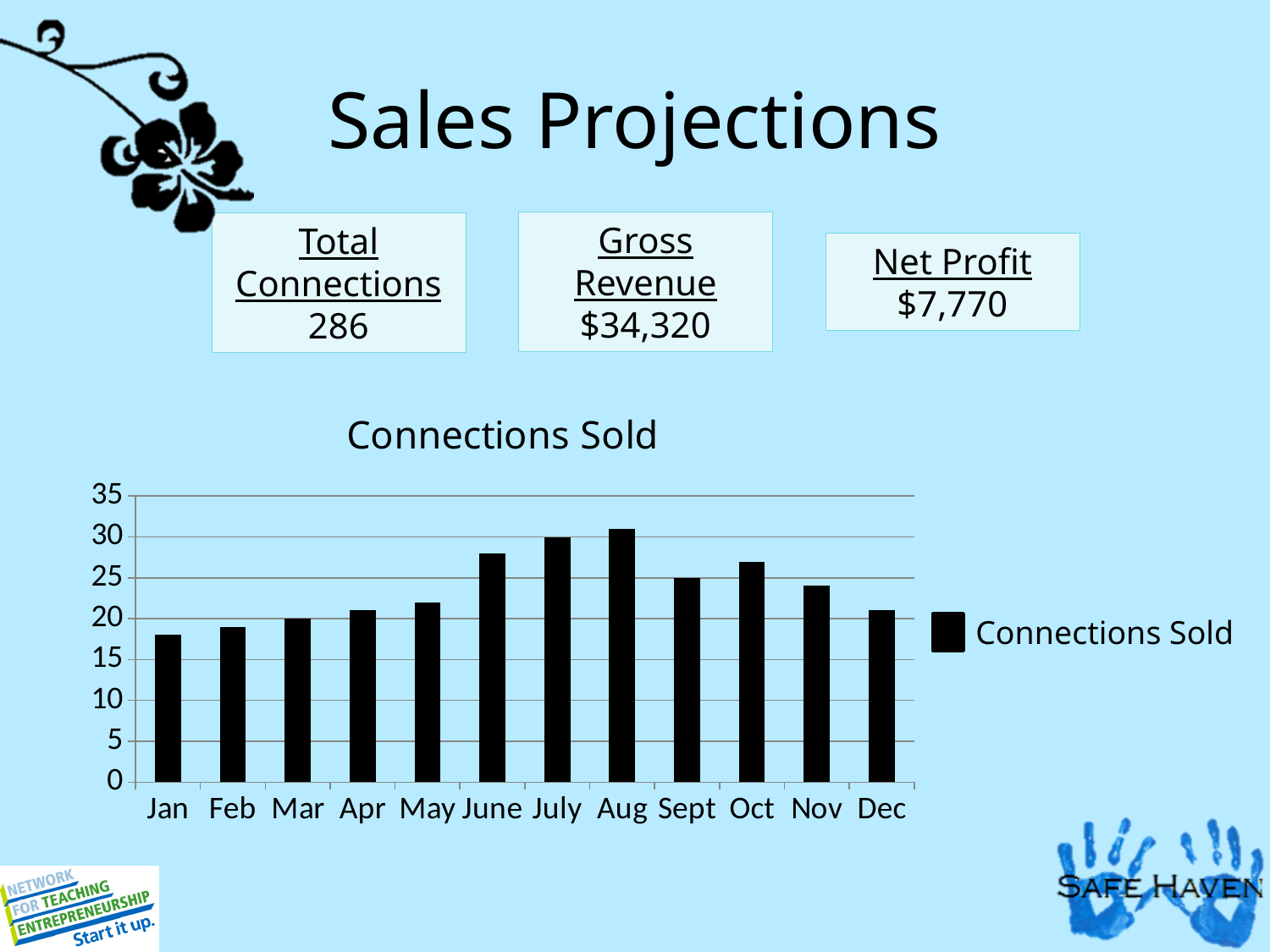
What is the value for Mar in the Connections Sold chart? 20 Which month has the larger value, Feb or Sept? Sept Is the value for Aug greater or less than 30? greater Do the values rise or fall from Jan to Aug? rise What is the title of the chart? Connections Sold What is the value for July in the Connections Sold chart? 30 Is the value for Jan greater or less than 20? less Is the value for Nov greater or less than 25? less What kind of chart is shown on the slide? bar chart How many months are shown on the x axis of the chart? 12 How many series does the chart's legend list? 1 Which month has the larger value, June or Dec? June